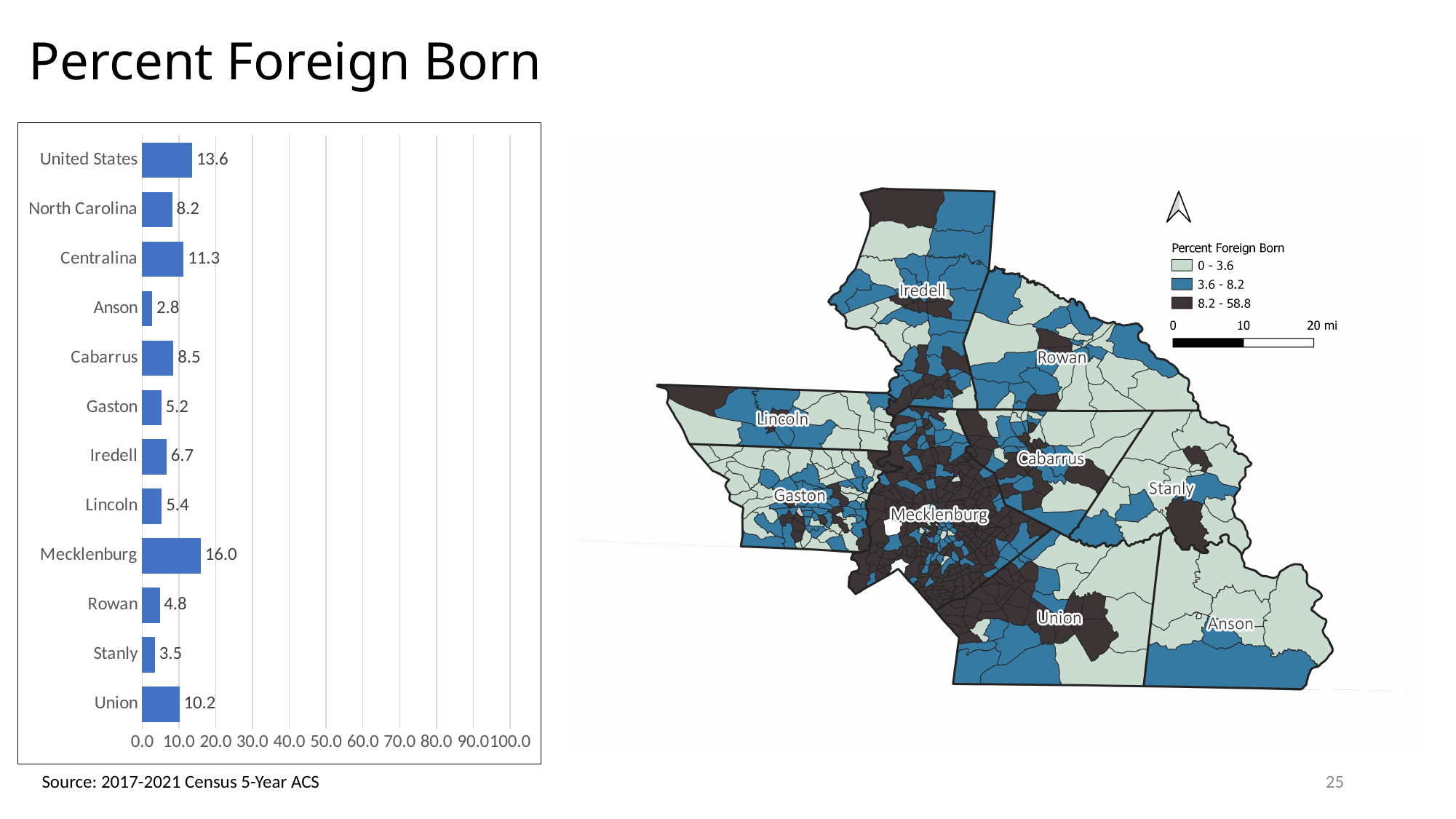
Which category has the lowest value in the bar chart? Anson What is the percent foreign born value for the United States in the bar chart? 13.6 What is the percent foreign born value for Mecklenburg in the bar chart? 16.0 What is the value for Stanly in the bar chart? 3.5 What is the highest value on the x axis of the bar chart? 100.0 Which has a larger value in the bar chart, Union or Cabarrus? Union Which category has the highest value in the bar chart? Mecklenburg Is the value for Centralina in the bar chart greater or less than 10.0? greater What is the percent foreign born value for Anson in the bar chart? 2.8 What is the difference between the values for Mecklenburg and North Carolina in the bar chart? 7.8 How many categories are shown in the bar chart? 12 What kind of chart is shown on the left of the slide? bar chart